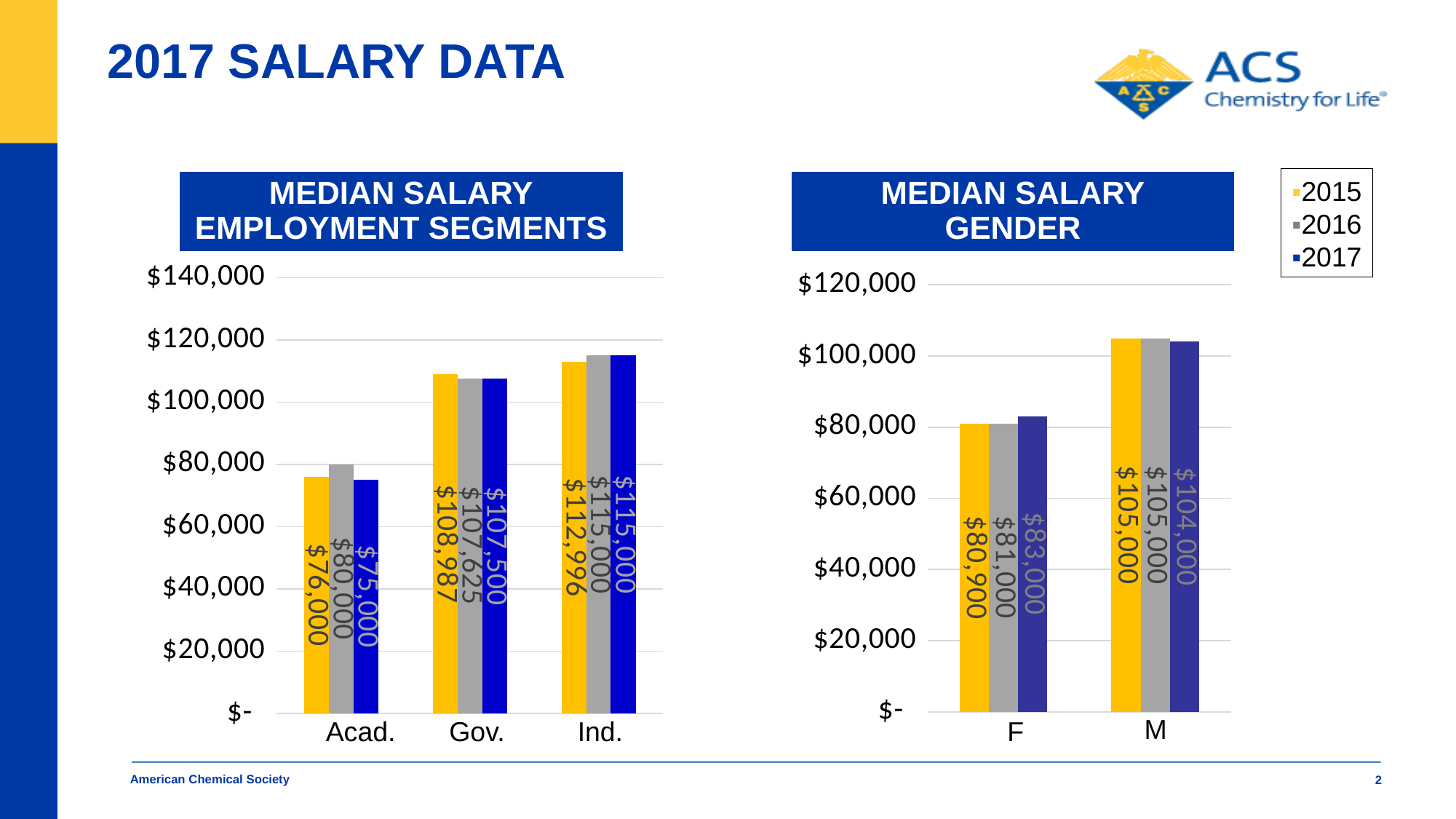
What kind of chart is the Median Salary Gender chart? bar chart How many series does the legend list? 3 In the Median Salary Employment Segments chart, what is the 2017 median salary for Gov.? $107,500 In the Median Salary Employment Segments chart, what is the difference between the 2016 and 2017 median salaries for Acad.? $5,000 In the Median Salary Gender chart, what is the 2017 median salary for F? $83,000 In the Median Salary Employment Segments chart, which category has the lowest 2016 median salary? Acad. In the Median Salary Gender chart, what is the 2015 median salary for M? $105,000 In the Median Salary Employment Segments chart, what is the 2016 median salary for Ind.? $115,000 In the Median Salary Gender chart, what is the difference between the 2017 median salaries for M and F? $21,000 In the Median Salary Employment Segments chart, what is the 2015 median salary for Acad.? $76,000 In the Median Salary Employment Segments chart, which category has the highest 2017 median salary? Ind. In the Median Salary Employment Segments chart, is the 2015 median salary for Gov. greater or less than $100,000? greater